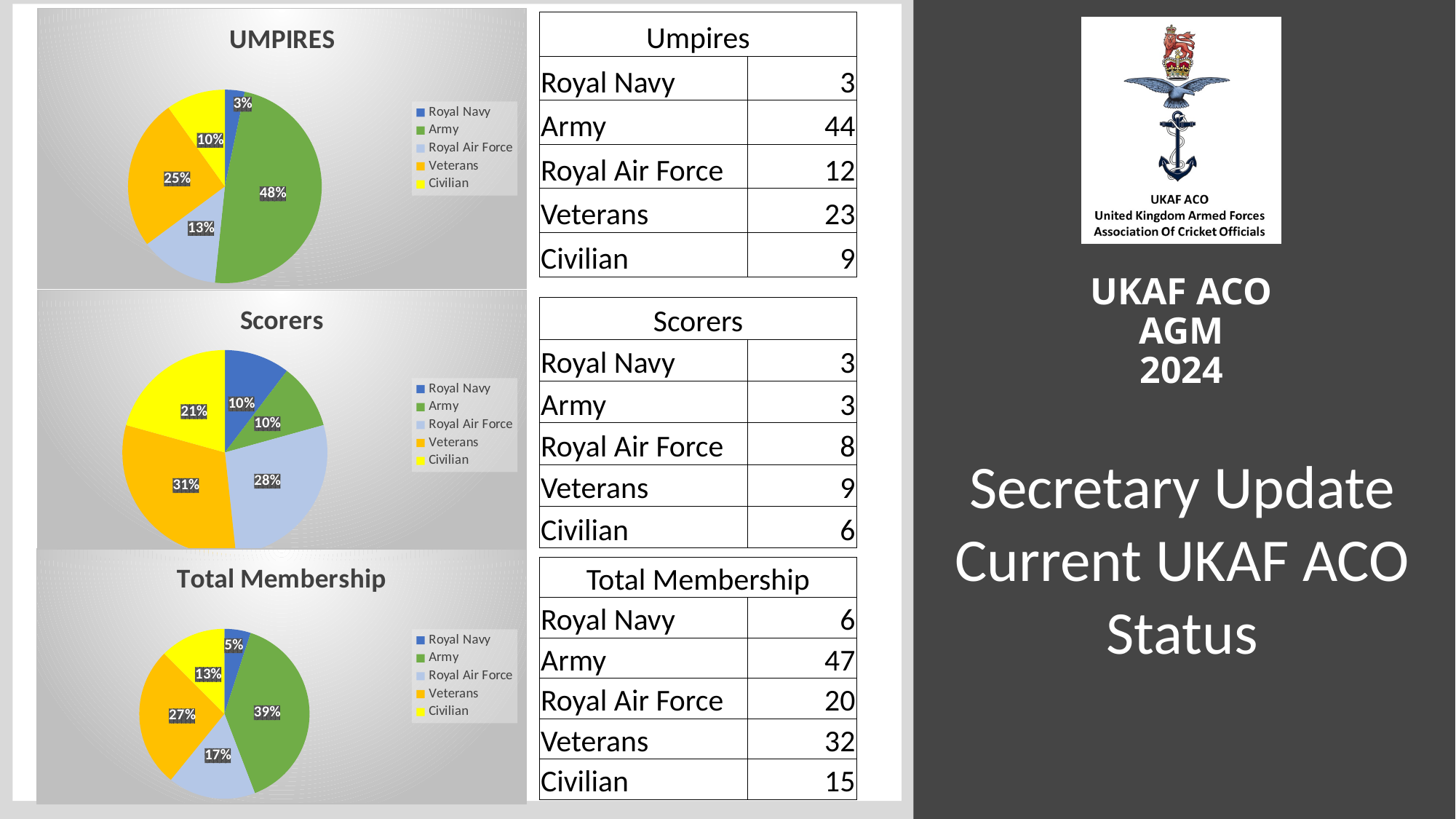
What type of chart is the UMPIRES chart? Pie chart In the UMPIRES chart, what share of the pie does Army hold? 48% In the Scorers chart, what is the difference in percentage points between Civilian and Royal Navy? 11 In the Total Membership chart, which category has the largest slice? Army In the Scorers chart, what percentage is shown for Royal Air Force? 28% In the UMPIRES chart, which category has the smallest slice? Royal Navy How many categories does the Scorers chart show? 5 In the Scorers chart, which category has the largest slice? Veterans In the Total Membership chart, which colour represents Veterans? Orange In the Total Membership chart, which is larger, Veterans or Royal Air Force? Veterans In the Total Membership chart, what percentage is shown for Civilian? 13% In the UMPIRES chart, what percentage is shown for Veterans? 25%